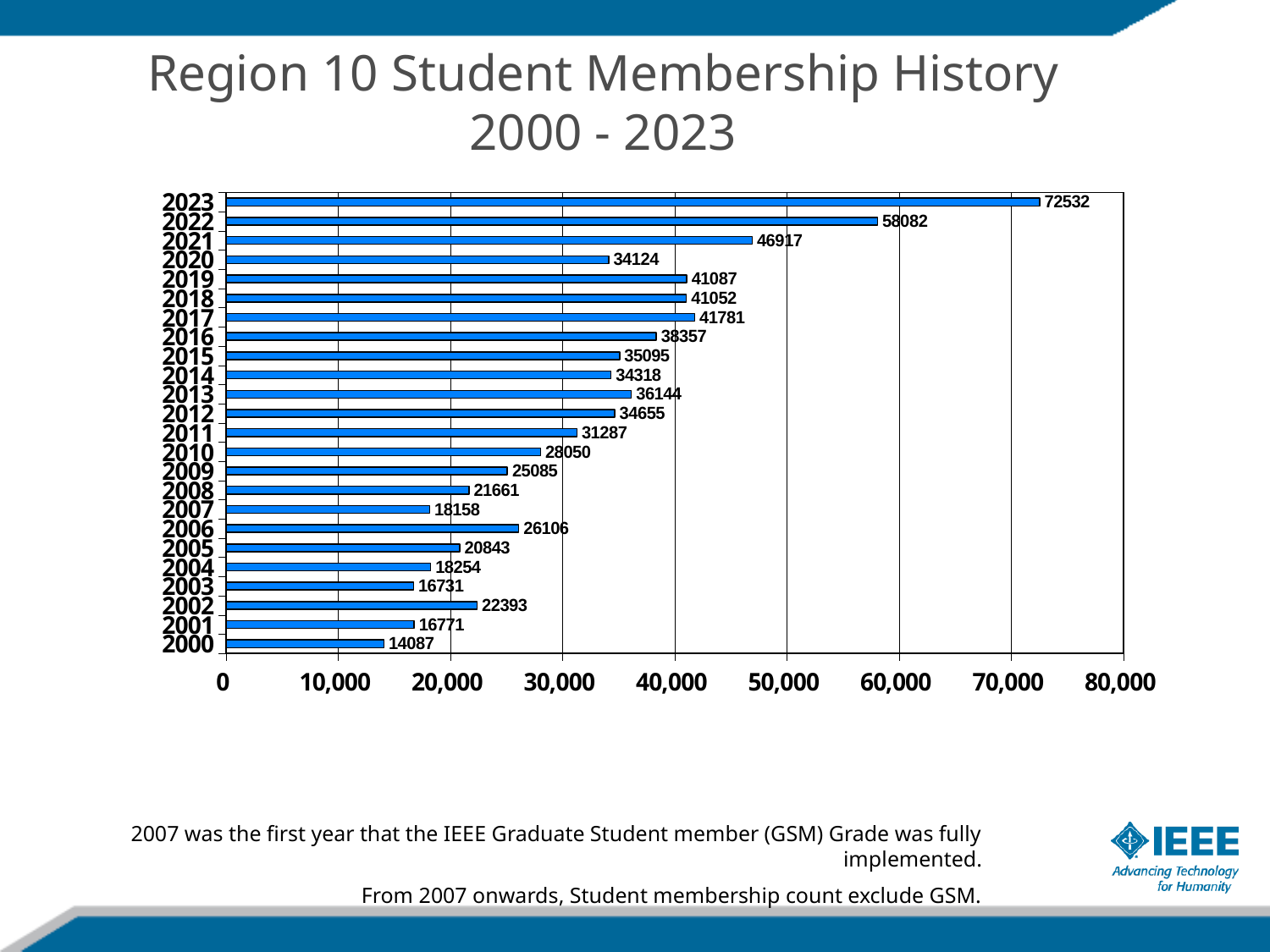
Which year has the highest student membership? 2023 What is the student membership value for 2013? 36144 What is the student membership value for 2007? 18158 What is the difference between the 2020 and 2019 values? 6963 What type of chart is shown on the slide? bar chart Which is larger, the value for 2006 or the value for 2007? 2006 What is the title of the chart on the slide? Region 10 Student Membership History 2000 - 2023 How many years are plotted in the chart? 24 What is the student membership value for 2023? 72532 What is the difference between the 2023 and 2022 values? 14450 Which year has the lowest student membership? 2000 Is the value for 2021 greater or less than 40,000? greater